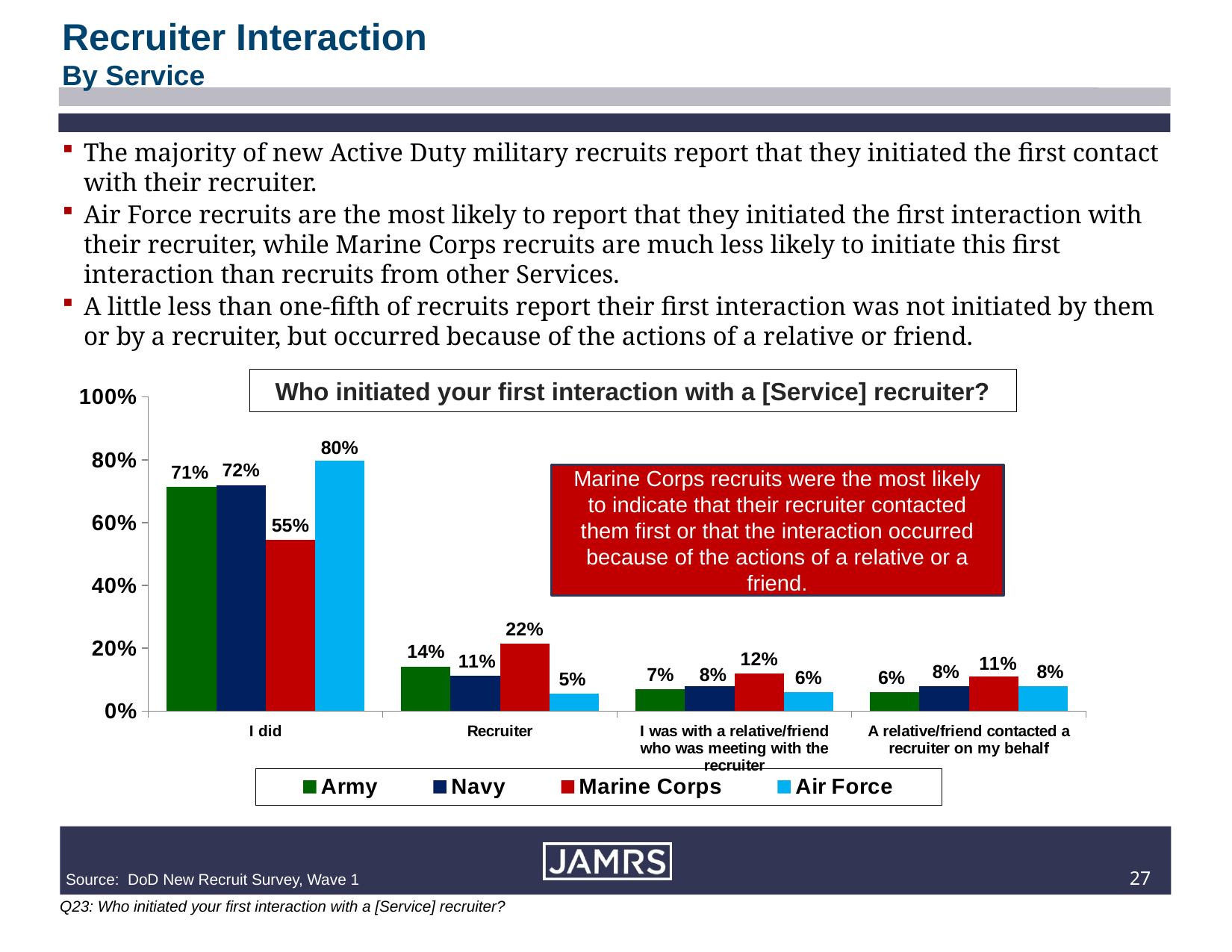
What is the Navy value for "A relative/friend contacted a recruiter on my behalf"? 8% What is the title of the chart? Who initiated your first interaction with a [Service] recruiter? Which service has the lowest value for "Recruiter"? Air Force What kind of chart is shown on the slide? bar chart Which service has the highest value for "I did"? Air Force Is the Marine Corps value for "I did" greater or less than 60%? less Which is larger for "I was with a relative/friend who was meeting with the recruiter": Marine Corps or Army? Marine Corps What is the difference between the Air Force and Marine Corps values for "I did"? 25% How many response categories are shown on the x axis? 4 What percentage of Marine Corps recruits said the recruiter initiated the first interaction? 22% What percentage of Air Force recruits said "I did" initiated the first interaction? 80% How many series does the legend list? 4